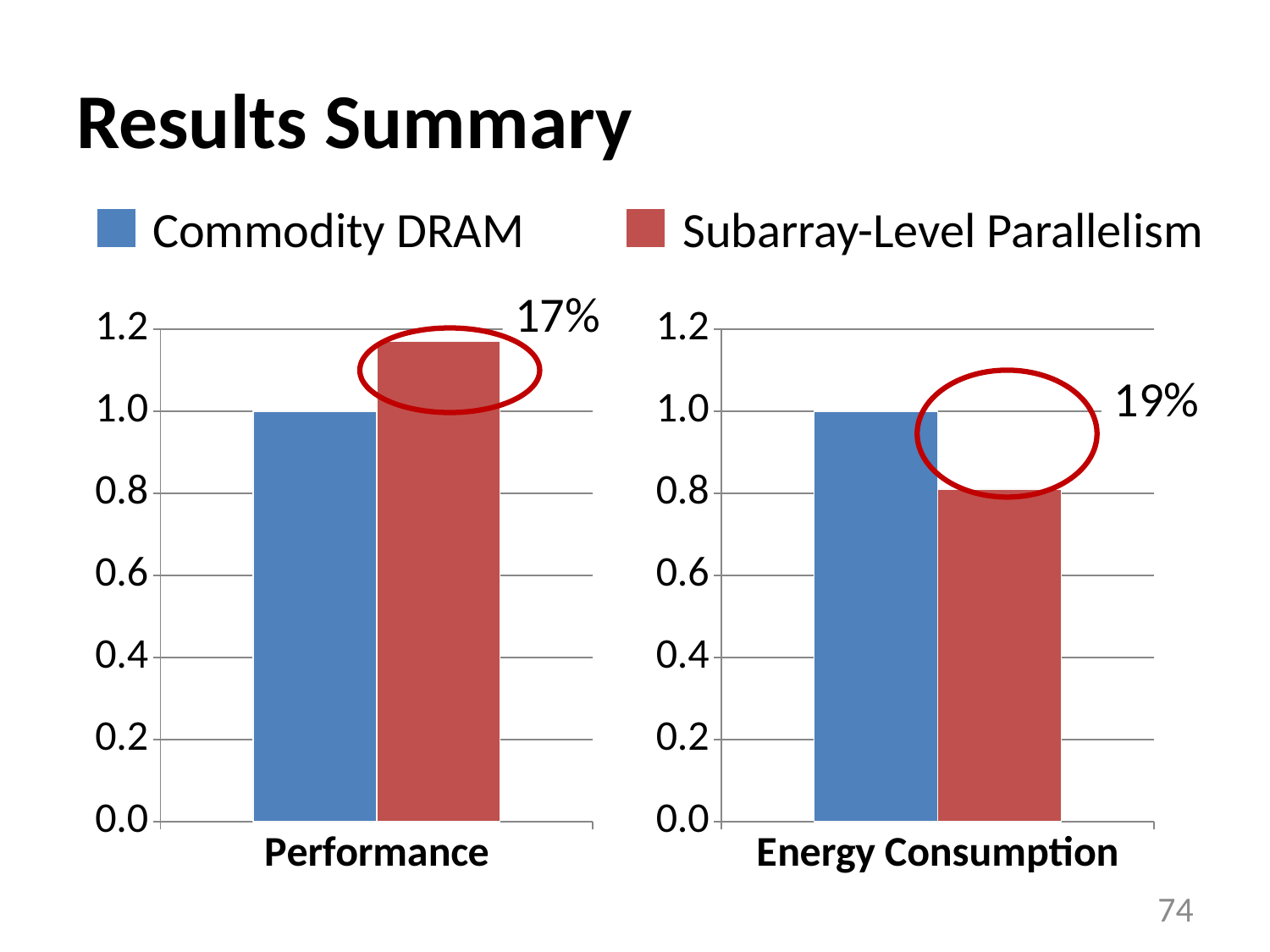
How many bars are plotted on the Performance chart? 2 On the Performance chart, is the value for Subarray-Level Parallelism greater or less than 1.0? greater On the Performance chart, what is the value for Commodity DRAM? 1.0 On the Energy Consumption chart, is the bar for Commodity DRAM or Subarray-Level Parallelism taller? Commodity DRAM Which colour represents Subarray-Level Parallelism in the legend? red How many series does the legend list? 2 On the Energy Consumption chart, is the value for Subarray-Level Parallelism greater or less than 1.0? less On the Energy Consumption chart, what is the value for Commodity DRAM? 1.0 What percentage is annotated next to the circled bar on the Performance chart? 17% On the Energy Consumption chart, which series has the lower bar? Subarray-Level Parallelism On the Performance chart, which series has the higher bar? Subarray-Level Parallelism What kind of chart is used on the Performance chart? bar chart